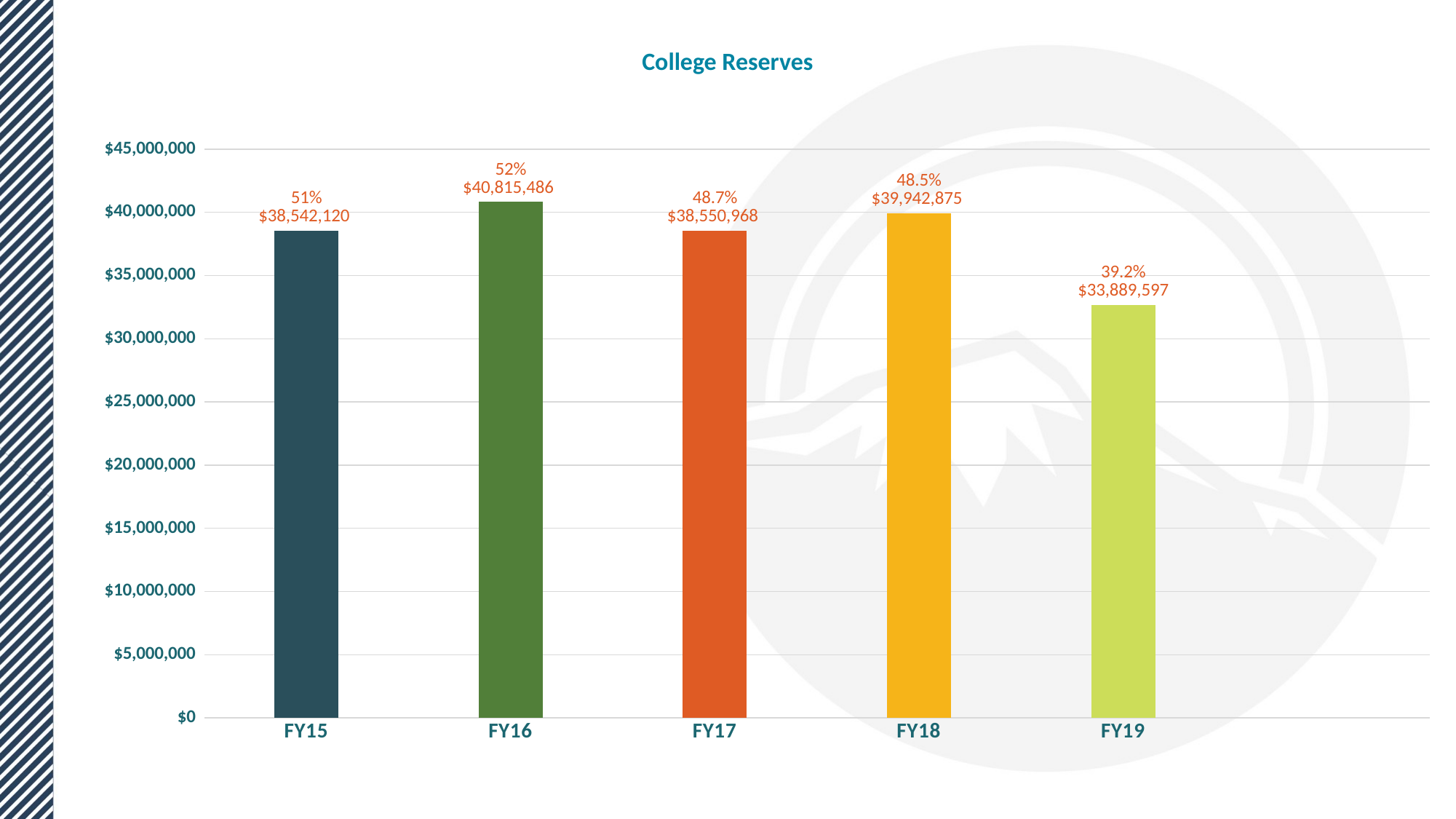
What is the value for FY19 in the College Reserves chart? $33,889,597 What is the difference between the FY16 and FY19 values? $6,925,889 Which is larger, the value for FY16 or the value for FY18? FY16 What is the title of the chart? College Reserves What kind of chart is shown on the slide? bar chart What percentage is shown above the FY15 bar? 51% Which fiscal year has the lowest College Reserves value? FY19 What is the value for FY16 in the College Reserves chart? $40,815,486 Is the value for FY19 greater or less than $35,000,000? less Which fiscal year has the highest College Reserves value? FY16 What percentage is shown above the FY17 bar? 48.7% How many fiscal years are shown in the chart? 5